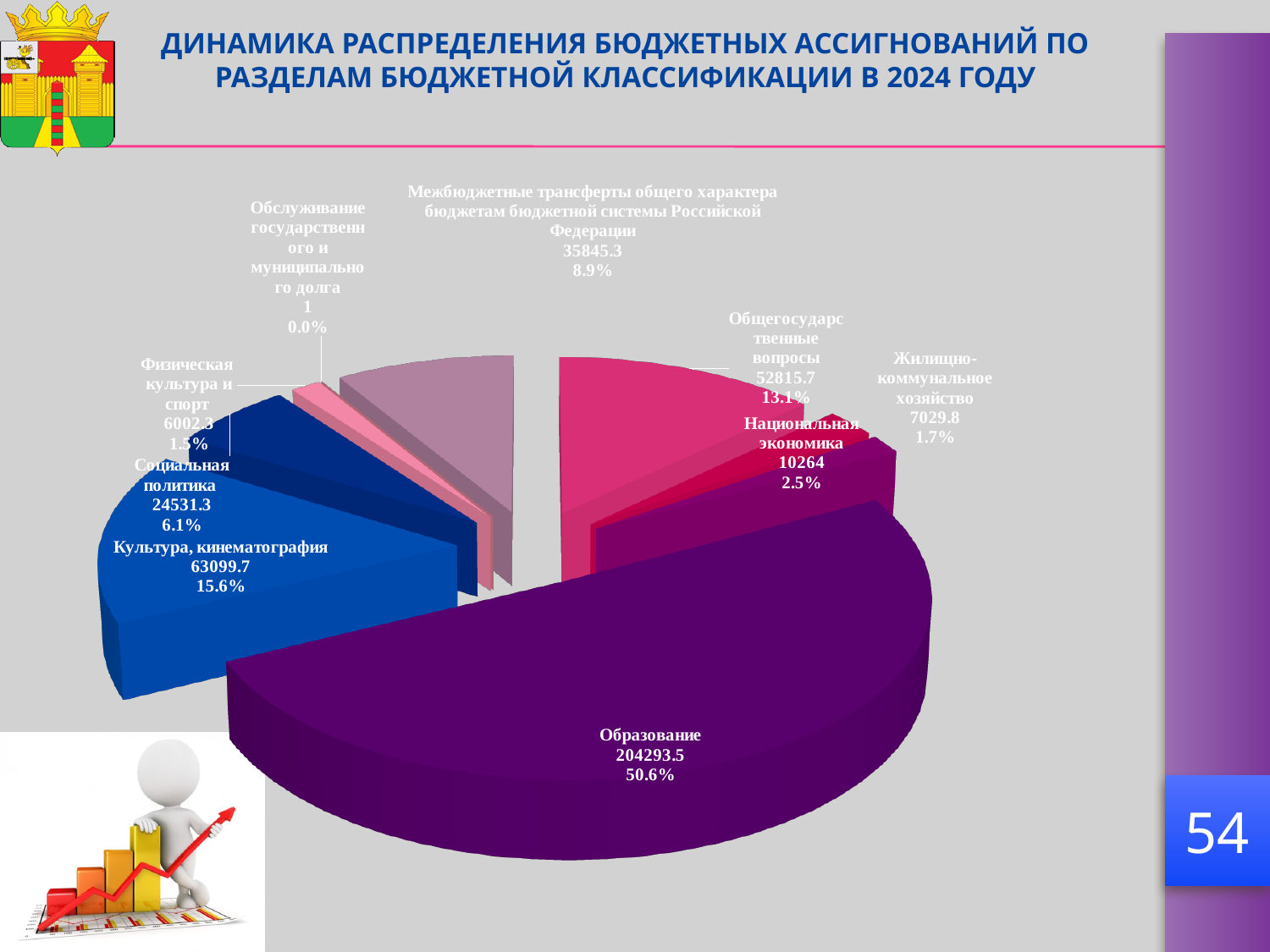
Which is larger: the value for Национальная экономика or the value for Жилищно-коммунальное хозяйство? Национальная экономика What kind of chart is shown on the slide? Pie chart What year does the chart title say the budget allocation distribution refers to? 2024 What is the value shown for Социальная политика? 24531.3 How many categories (slices) does the pie chart show? 9 Which category has the smallest share of the pie? Обслуживание государственного и муниципального долга What share of the pie does Межбюджетные трансферты общего характера бюджетам бюджетной системы Российской Федерации have? 8.9% What is the value shown for Образование? 204293.5 What is the difference between the values for Культура, кинематография and Общегосударственные вопросы? 10284 Which category has the largest share of the pie? Образование What share of the pie does Культура, кинематография have? 15.6% What is the value shown for Общегосударственные вопросы? 52815.7